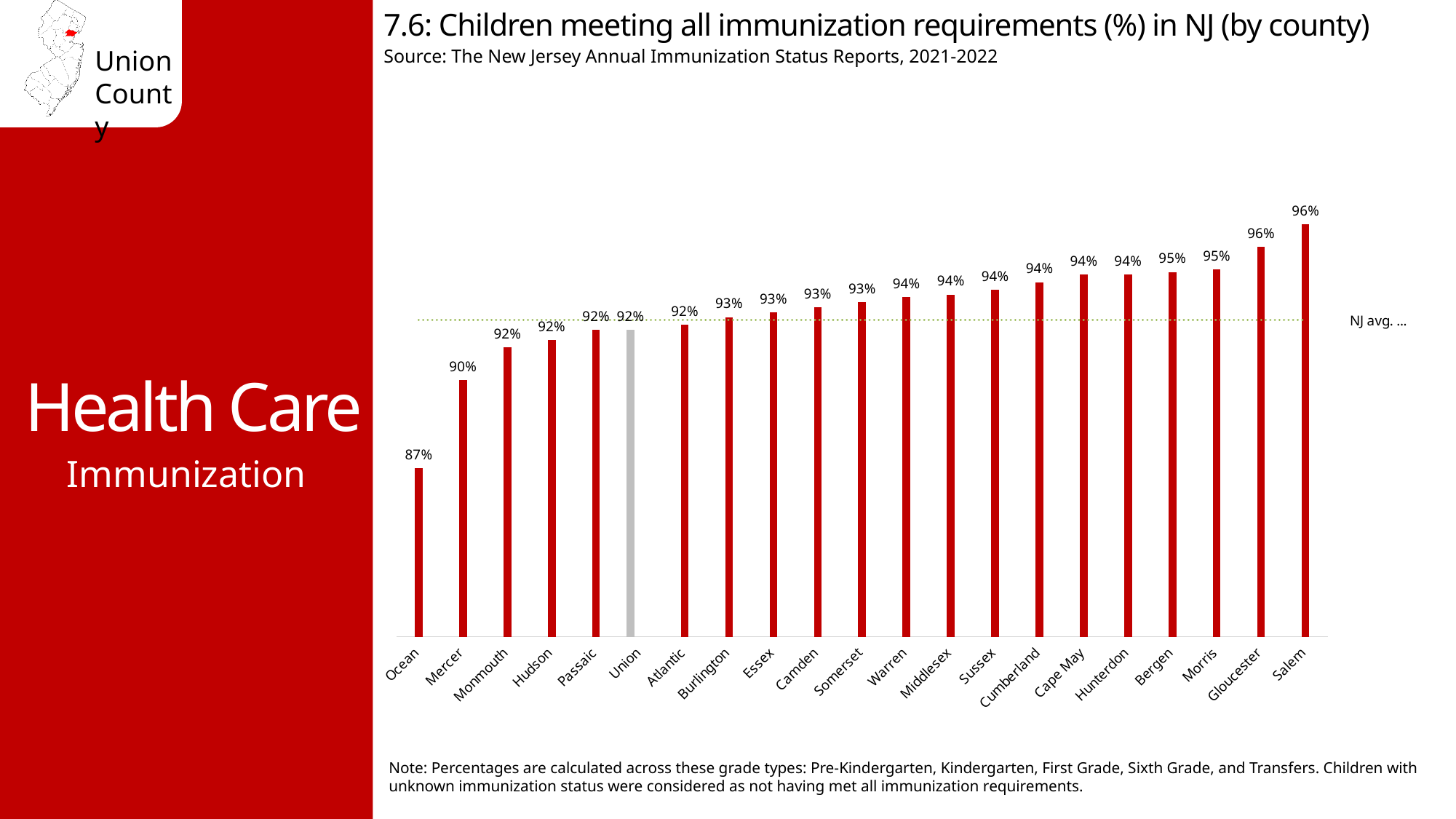
What is the difference in percentage points between Union and Ocean? 5 percentage points What kind of chart is shown on the slide? Bar chart What is the value shown for Bergen County? 95% What is the value shown for Mercer County? 90% How many counties are shown in the chart? 21 What is the difference in percentage points between Salem and Ocean? 9 percentage points Do the values rise or fall moving from left to right along the x axis? Rise Which county has the lowest percentage of children meeting all immunization requirements? Ocean What is the value shown for Ocean County? 87% Which has a higher value, Mercer or Monmouth? Monmouth What percentage of children in Union County met all immunization requirements? 92% Which county has the tallest bar in the chart? Salem